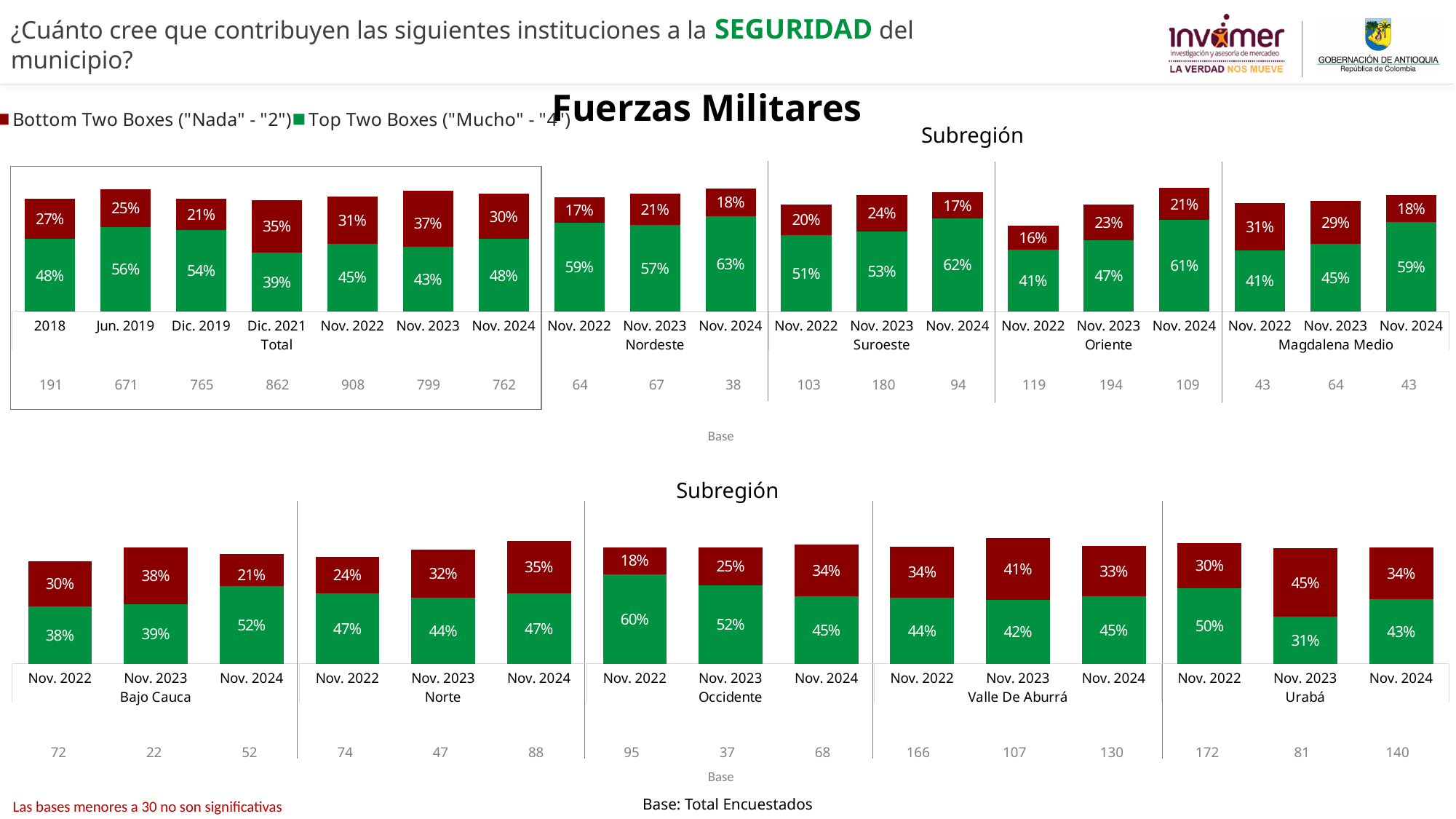
In the top chart, what is the combined total of the Top Two Boxes and Bottom Two Boxes segments for Total in Dic. 2021? 74% In the bottom chart, which bar has the lowest Top Two Boxes value? Urabá Nov. 2023 In the bottom chart, which has the larger Top Two Boxes value in Nov. 2022: Occidente or Valle De Aburrá? Occidente In the top chart, within the Total group, which period has the highest Top Two Boxes value? Jun. 2019 Which institution is the chart on this slide about? Fuerzas Militares In the top chart, what is the Top Two Boxes ("Mucho" - "4") value for Nordeste in Nov. 2024? 63% How many series does the legend list? 2 What kind of chart is shown on the slide? Stacked bar chart In the top chart, by how many percentage points did the Top Two Boxes value for Oriente increase from Nov. 2022 to Nov. 2024? 20 percentage points In the top chart, does the Top Two Boxes value for Oriente rise or fall from Nov. 2022 to Nov. 2024? Rises In the bottom chart, what is the Bottom Two Boxes ("Nada" - "2") value for Urabá in Nov. 2023? 45% How many subregions are shown in the bottom chart? 5